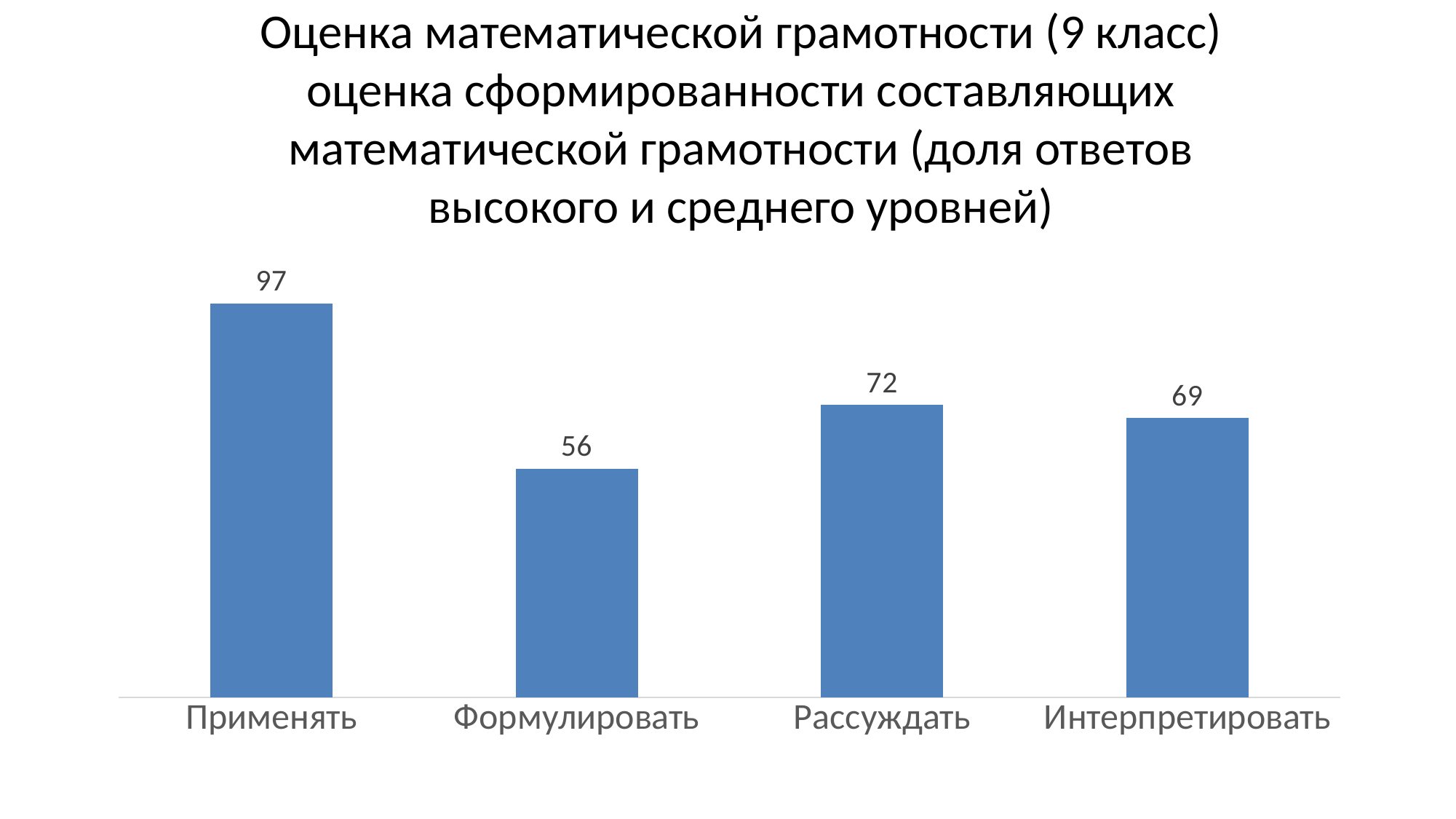
What is the difference between the values for Рассуждать and Интерпретировать? 3 Which is larger, the value for Рассуждать or the value for Формулировать? Рассуждать What is the value for Формулировать? 56 Which category has the highest value? Применять What is the difference between the values for Применять and Формулировать? 41 What is the value for Применять? 97 What kind of chart is shown on the slide? Bar chart What is the value for Рассуждать? 72 What is the value for Интерпретировать? 69 What colour are the bars in the chart? Blue How many categories are shown on the chart? 4 Which category has the lowest value? Формулировать